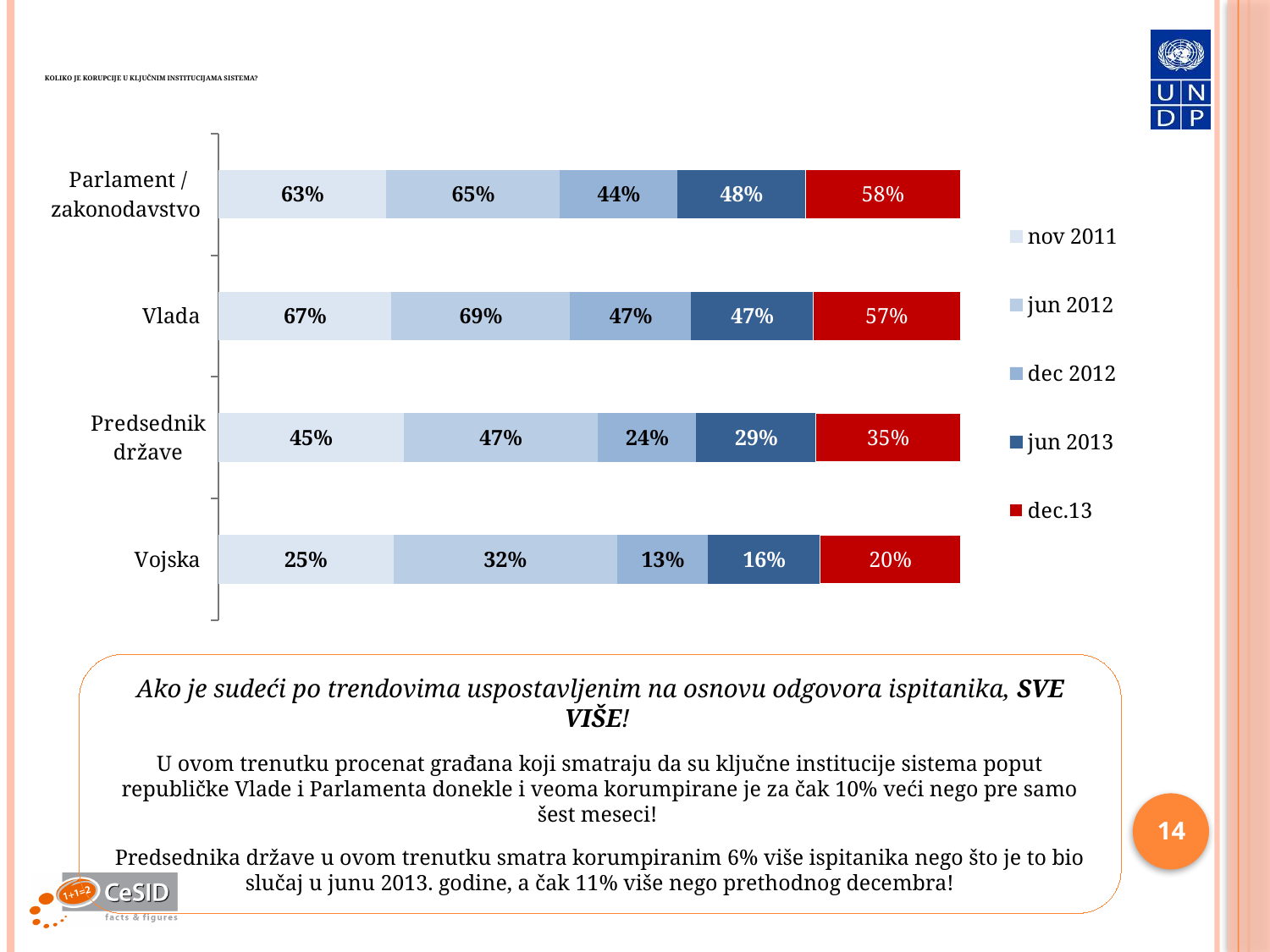
What is the value for Vojska in the dec 2012 series? 13% Which colour represents the dec.13 series in the legend? Red Which category has the lowest value in the jun 2013 series? Vojska In the nov 2011 series, which is larger: Parlament / zakonodavstvo or Vlada? Vlada What is the value for Vlada in the jun 2012 series? 69% Which category has the highest value in the nov 2011 series? Vlada What is the value for Predsednik države in the dec.13 series? 35% How many categories (institutions) are shown on the chart? 4 How many series does the legend list? 5 For Vojska, do the values rise or fall from dec 2012 through jun 2013 to dec.13? Rise For Parlament / zakonodavstvo, how much higher is the dec.13 value than the jun 2013 value? 10 percentage points What kind of chart is shown on the slide? Stacked bar chart